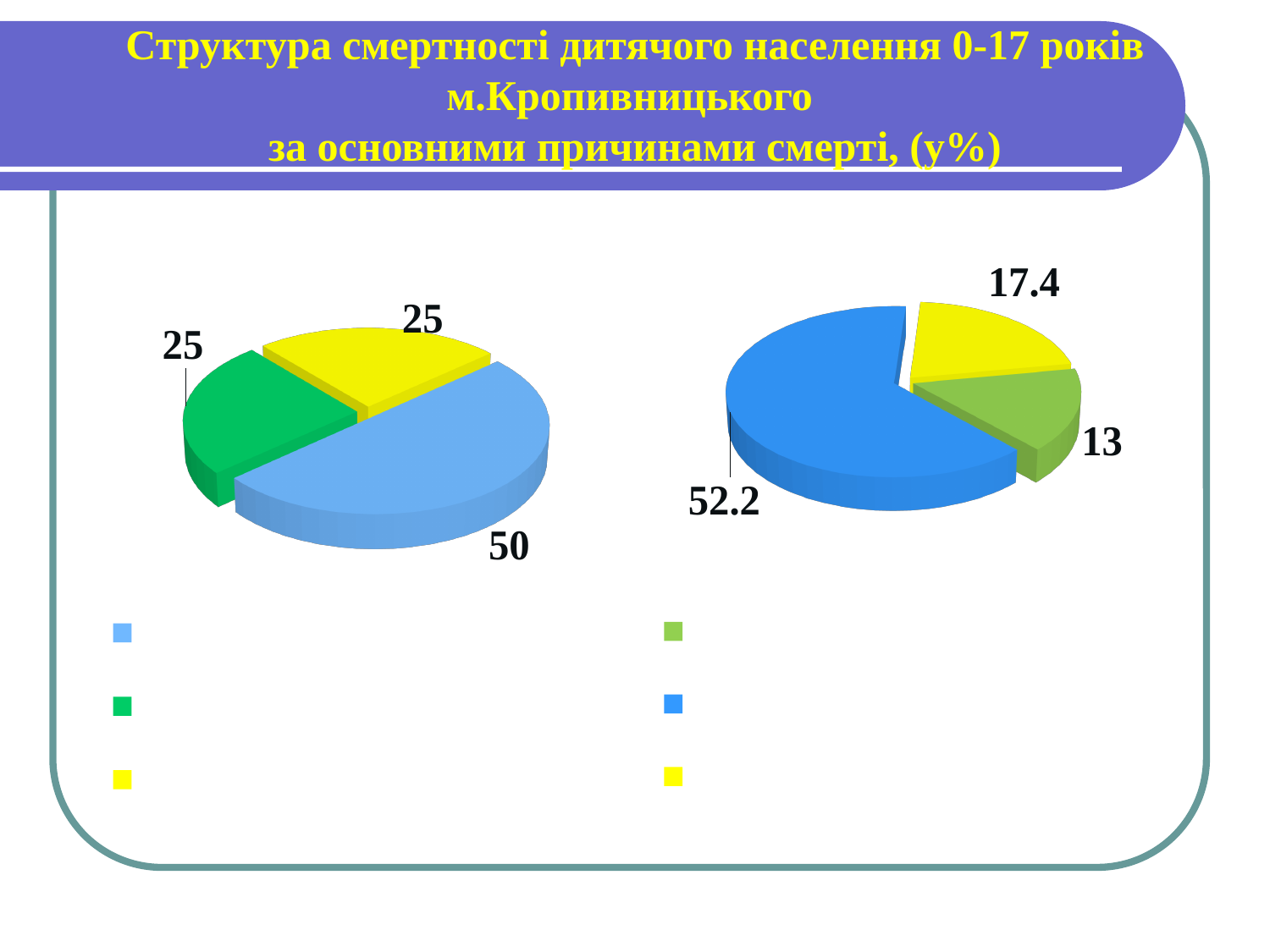
In the left pie chart, what value is shown for the light blue slice? 50 In the right pie chart, what value is shown for the blue slice? 52.2 What kind of charts are shown on the slide? Pie charts In the left pie chart, how many slices are there? 3 In the left pie chart, which slice is the largest? The light blue slice (50) In the right pie chart, what value is shown for the green slice? 13 In the left pie chart, what is the difference between the light blue slice and the yellow slice? 25 In the right pie chart, what value is shown for the yellow slice? 17.4 How many pie charts are on the slide? 2 In the left pie chart, what value is shown for the green slice? 25 In the right pie chart, what is the difference between the yellow slice and the green slice? 4.4 In the right pie chart, which slice is the smallest? The green slice (13)